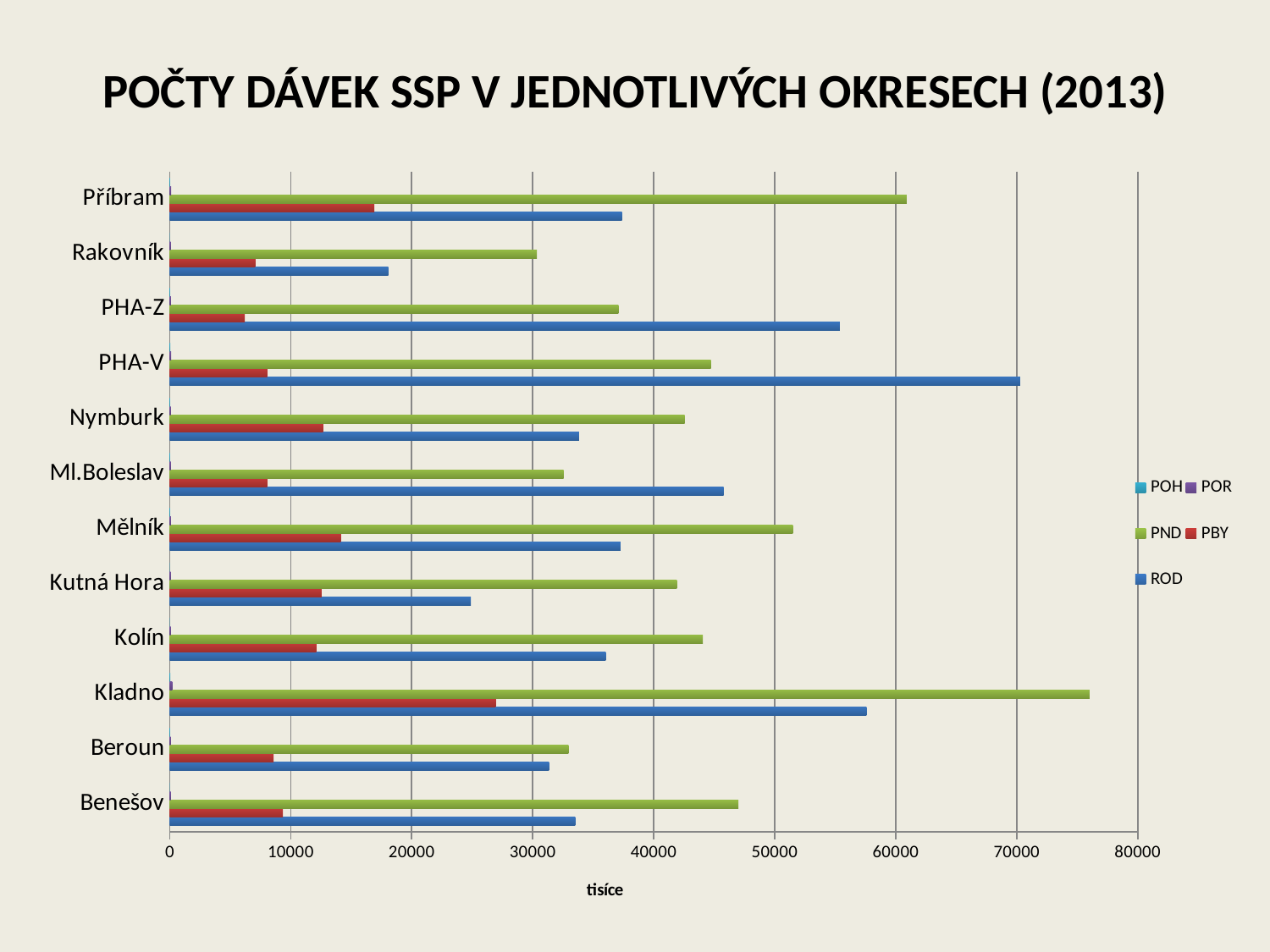
Which district has the lowest ROD value? Rakovník How many districts (categories) are listed on the vertical axis of the chart? 12 Which is larger, the ROD value for PHA-V or the ROD value for PHA-Z? PHA-V Is the ROD value for Kutná Hora greater or less than 30000? less Which district has the highest ROD value? PHA-V What kind of chart is shown on the slide? bar chart Which district has the highest PBY value? Kladno Is the ROD value for Rakovník greater or less than 20000? less Is the PND value for Kladno greater or less than 70000? greater Which district has the highest PND value? Kladno How many series does the chart legend list? 5 What is the title of the chart? POČTY DÁVEK SSP V JEDNOTLIVÝCH OKRESECH (2013)